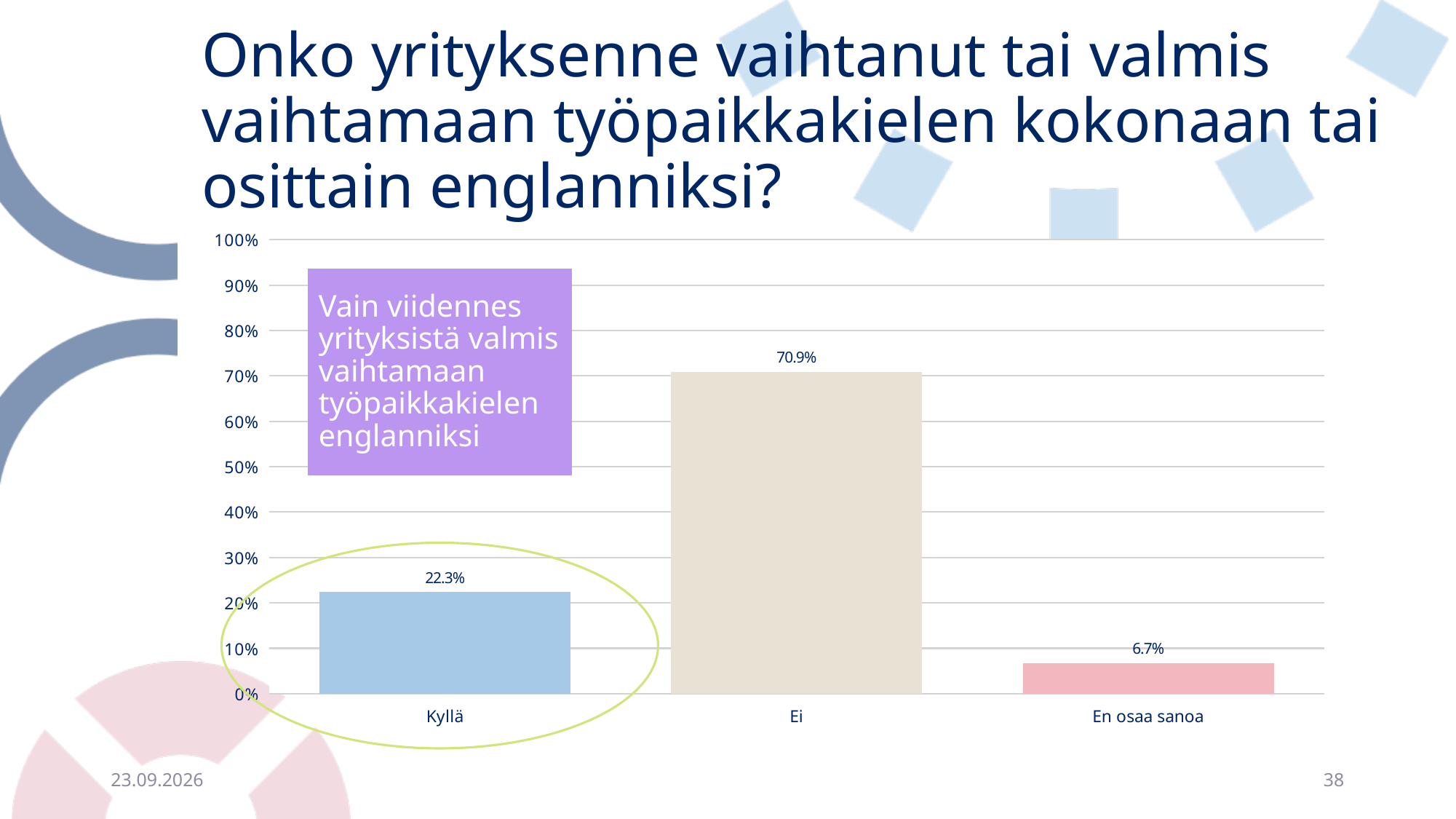
Which category is circled on the chart? Kyllä Which category has the highest value? Ei How many categories are shown on the x axis? 3 What is the value for En osaa sanoa? 6.7% What is the difference between the values for Kyllä and En osaa sanoa? 15.6% What is the difference between the values for Ei and Kyllä? 48.6% Is the value for Ei greater or less than 60%? greater Which is larger, the value for Kyllä or the value for En osaa sanoa? Kyllä What kind of chart is shown on the slide? bar chart What is the value for Kyllä? 22.3% Which category has the lowest value? En osaa sanoa What is the value for Ei? 70.9%